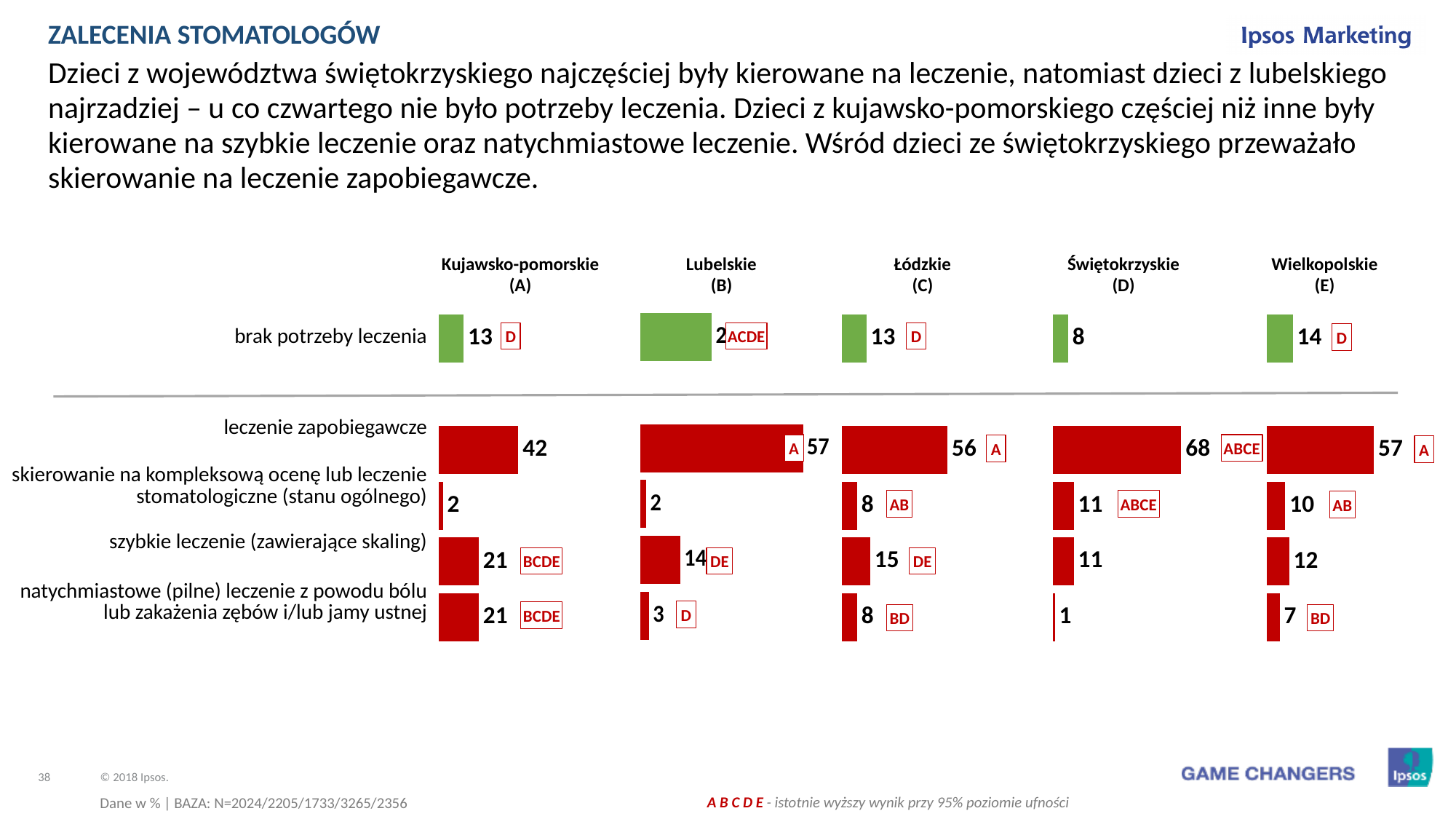
Which voivodeship has the highest value for leczenie zapobiegawcze? Świętokrzyskie (D) What is the value for leczenie zapobiegawcze in Świętokrzyskie (D)? 68 What is the value for natychmiastowe (pilne) leczenie in Świętokrzyskie (D)? 1 Which is larger: the szybkie leczenie value for Lubelskie (B) or for Łódzkie (C)? Łódzkie (C) What is the value for szybkie leczenie (zawierające skaling) in Kujawsko-pomorskie (A)? 21 Which voivodeship has the lowest value for leczenie zapobiegawcze? Kujawsko-pomorskie (A) What is the value for brak potrzeby leczenia in Wielkopolskie (E)? 14 How many voivodeships are compared in the chart? 5 What is the difference between the leczenie zapobiegawcze values for Świętokrzyskie (D) and Kujawsko-pomorskie (A)? 26 What type of chart is used on the slide? Bar chart Which voivodeship has the lowest value for natychmiastowe (pilne) leczenie? Świętokrzyskie (D) What colour are the bars for brak potrzeby leczenia? Green